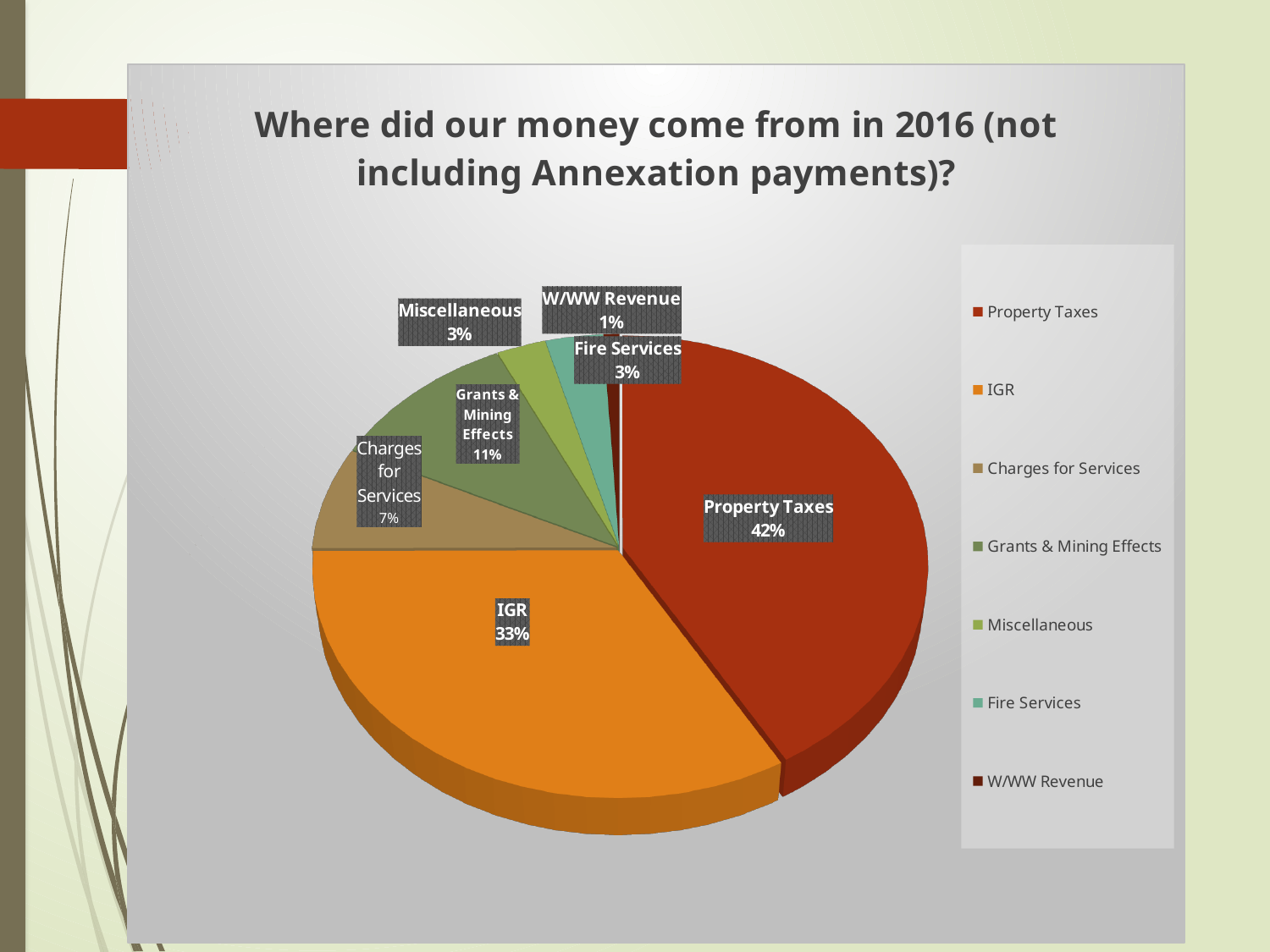
What is the title of the chart? Where did our money come from in 2016 (not including Annexation payments)? What is the value shown for IGR? 33% What is the value for Charges for Services? 7% What percentage is shown for Grants & Mining Effects? 11% Which is larger, Grants & Mining Effects or Charges for Services? Grants & Mining Effects How many categories are shown in the pie chart? 7 Which category has the largest share of the pie? Property Taxes Which category has the smallest share of the pie? W/WW Revenue What share of the pie does Property Taxes represent? 42% What is the difference between the Property Taxes share and the IGR share? 9% What kind of chart is shown on the slide? Pie chart What percentage is shown for W/WW Revenue? 1%